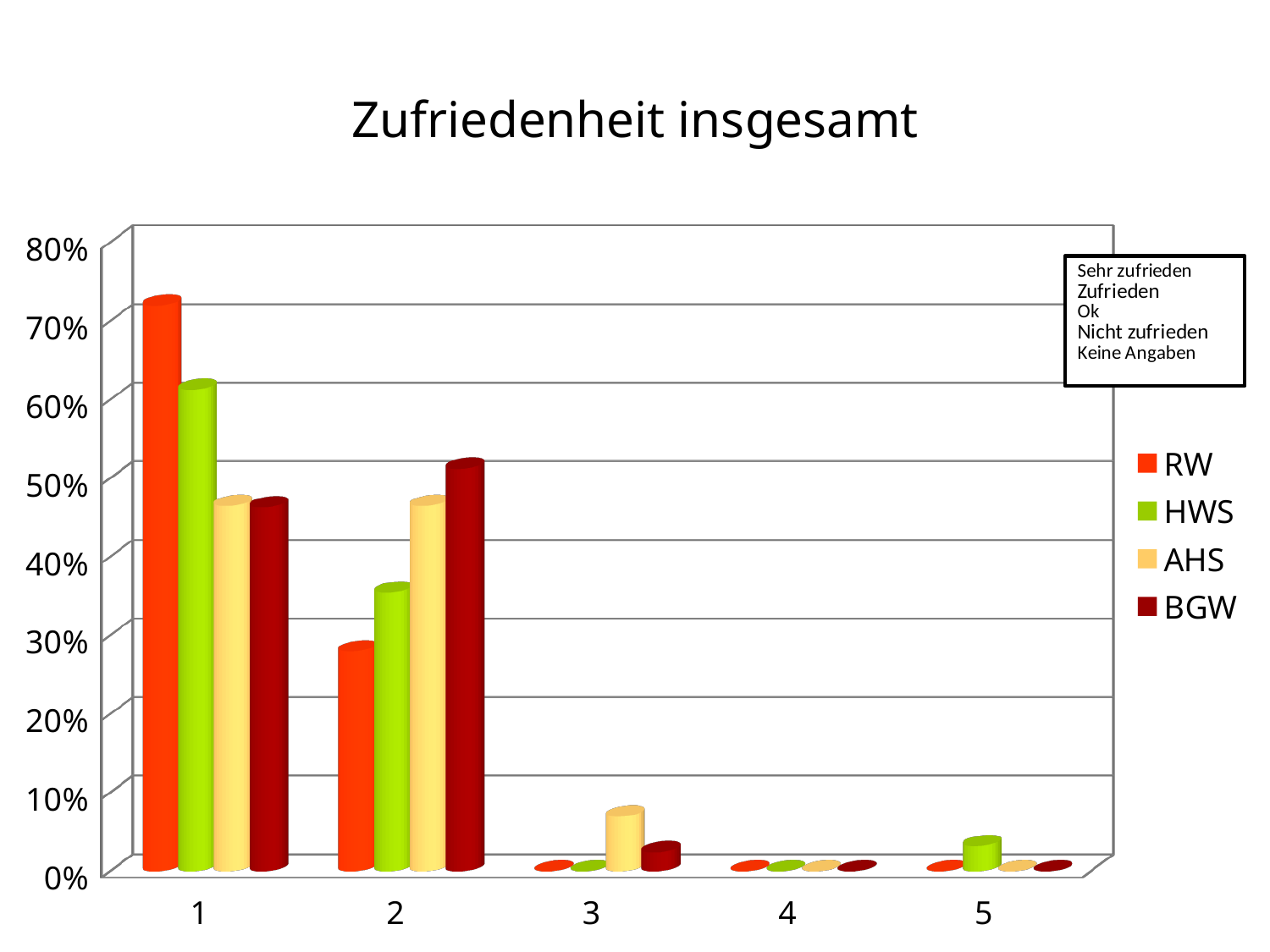
Which series has the lowest value for category 2? RW Which series has the highest value for category 1? RW For category 2, which is larger: RW or HWS? HWS What is the title of the chart? Zufriedenheit insgesamt How many categories are shown on the x axis? 5 How many series does the legend list? 4 What kind of chart is shown on the slide? bar chart Does the value for RW rise or fall from category 1 to category 2? fall Which series has the highest value for category 2? BGW Is the value for RW in category 1 greater or less than 60%? greater For category 1, which is larger: RW or HWS? RW Is the value for RW in category 2 greater or less than 40%? less